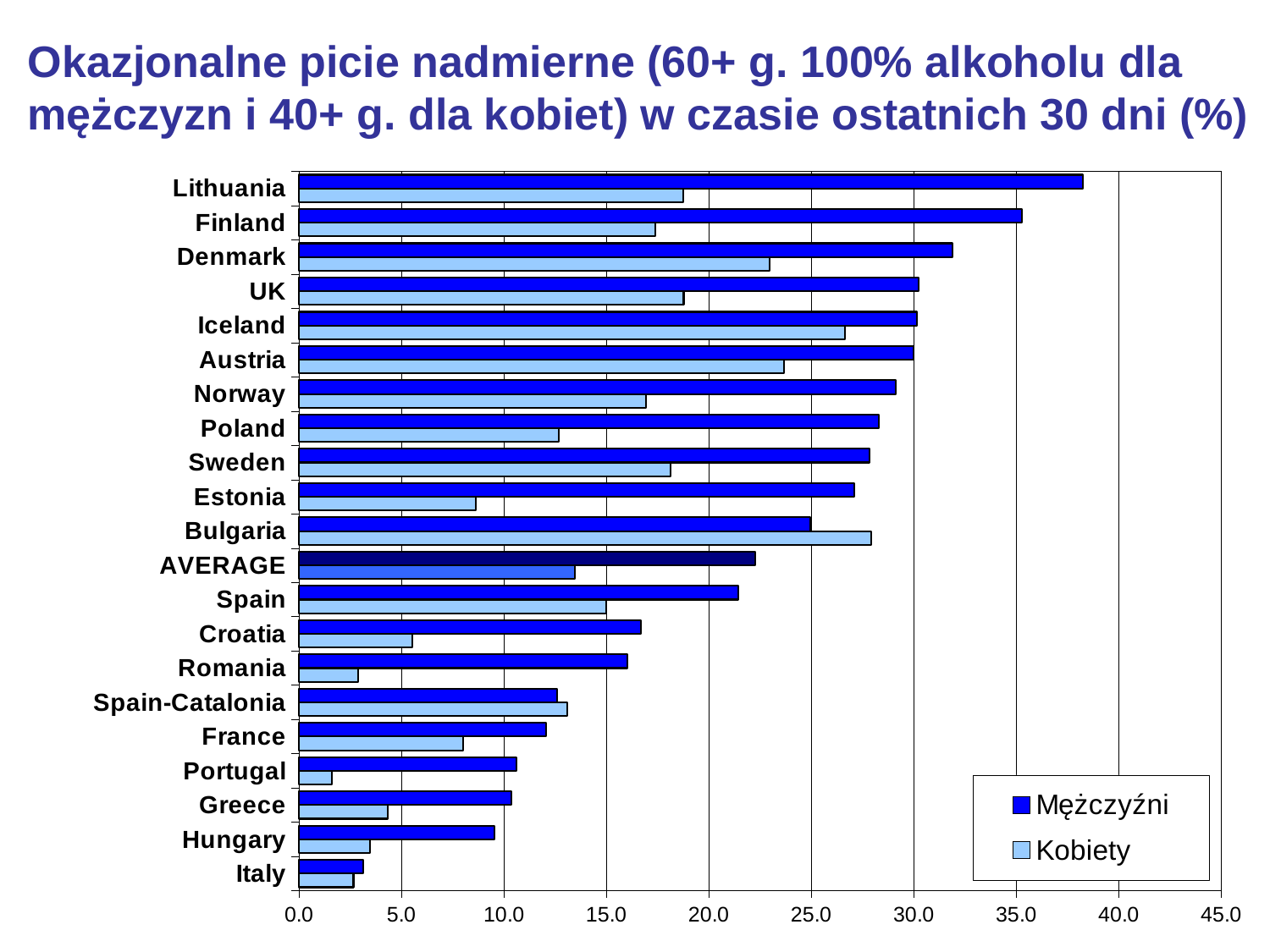
Is the Mężczyźni value for Denmark greater or less than 30.0? greater Which category has the lowest value for Mężczyźni? Italy Is the Kobiety value for Estonia greater or less than 10.0? less Do the Mężczyźni values rise or fall going down the list from Lithuania to Italy? fall How many categories are shown on the vertical axis? 21 Is the Mężczyźni value for Lithuania greater or less than 35.0? greater For Bulgaria, which series has the larger value, Mężczyźni or Kobiety? Kobiety What kind of chart is shown on the slide? bar chart What are the two series named in the legend? Mężczyźni and Kobiety Which category has the lowest value for Kobiety? Portugal Which category has the highest value for Mężczyźni? Lithuania How many series does the legend list? 2